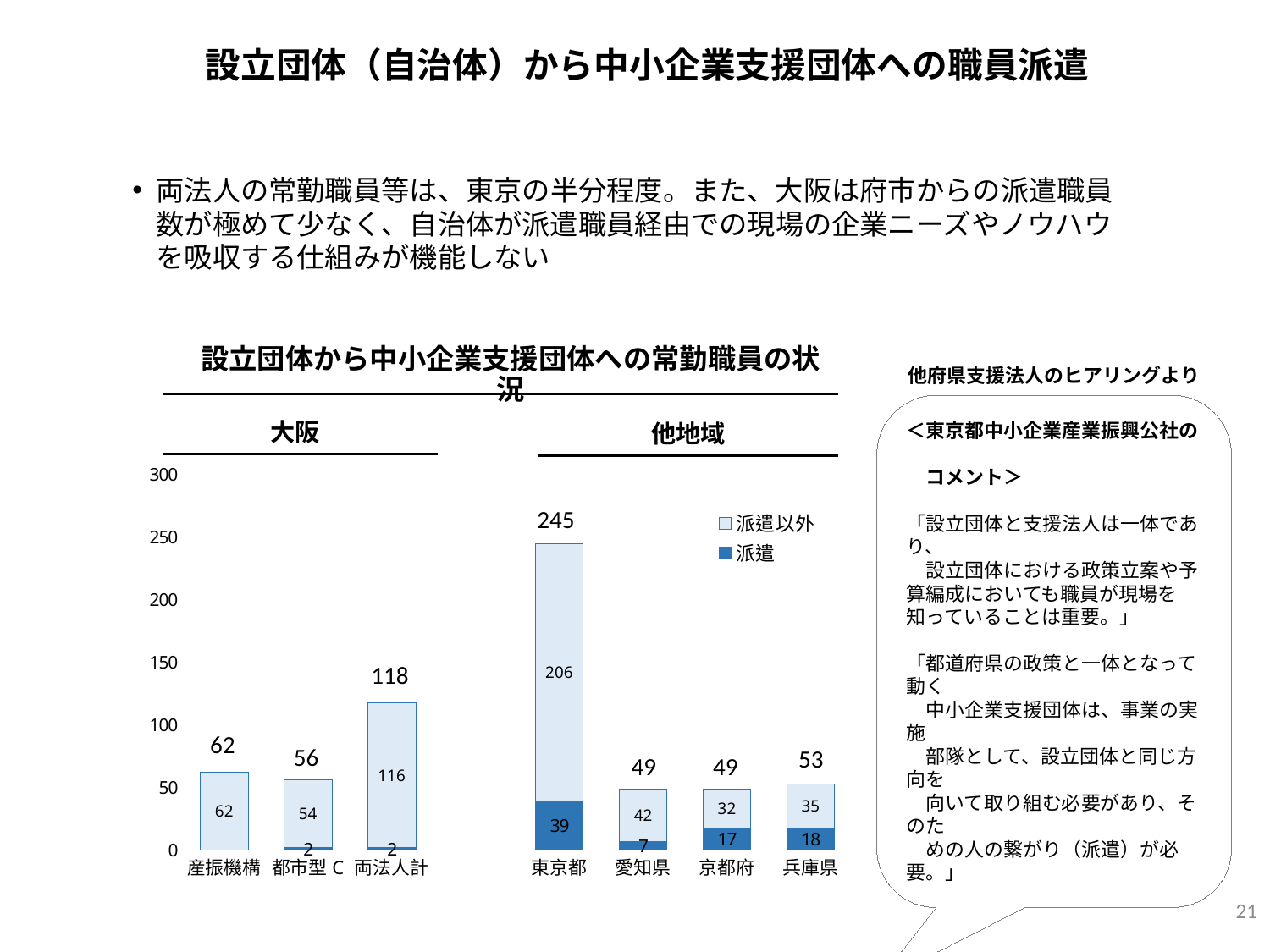
Is the total for 両法人計 greater or less than 100? greater What is the difference between the totals for 両法人計 and 東京都? 127 Which is larger, the 派遣 value for 兵庫県 or for 愛知県? 兵庫県 What is the 派遣 value for 京都府? 17 What is the 派遣 value for 東京都? 39 How many series does the legend list? 2 What type of chart is shown on the slide? stacked bar chart What are the two series listed in the legend? 派遣以外 and 派遣 How many categories are plotted on the x axis? 7 What is the 派遣以外 value for 両法人計? 116 Which category has the highest total? 東京都 What is the total value of the bar for 東京都? 245